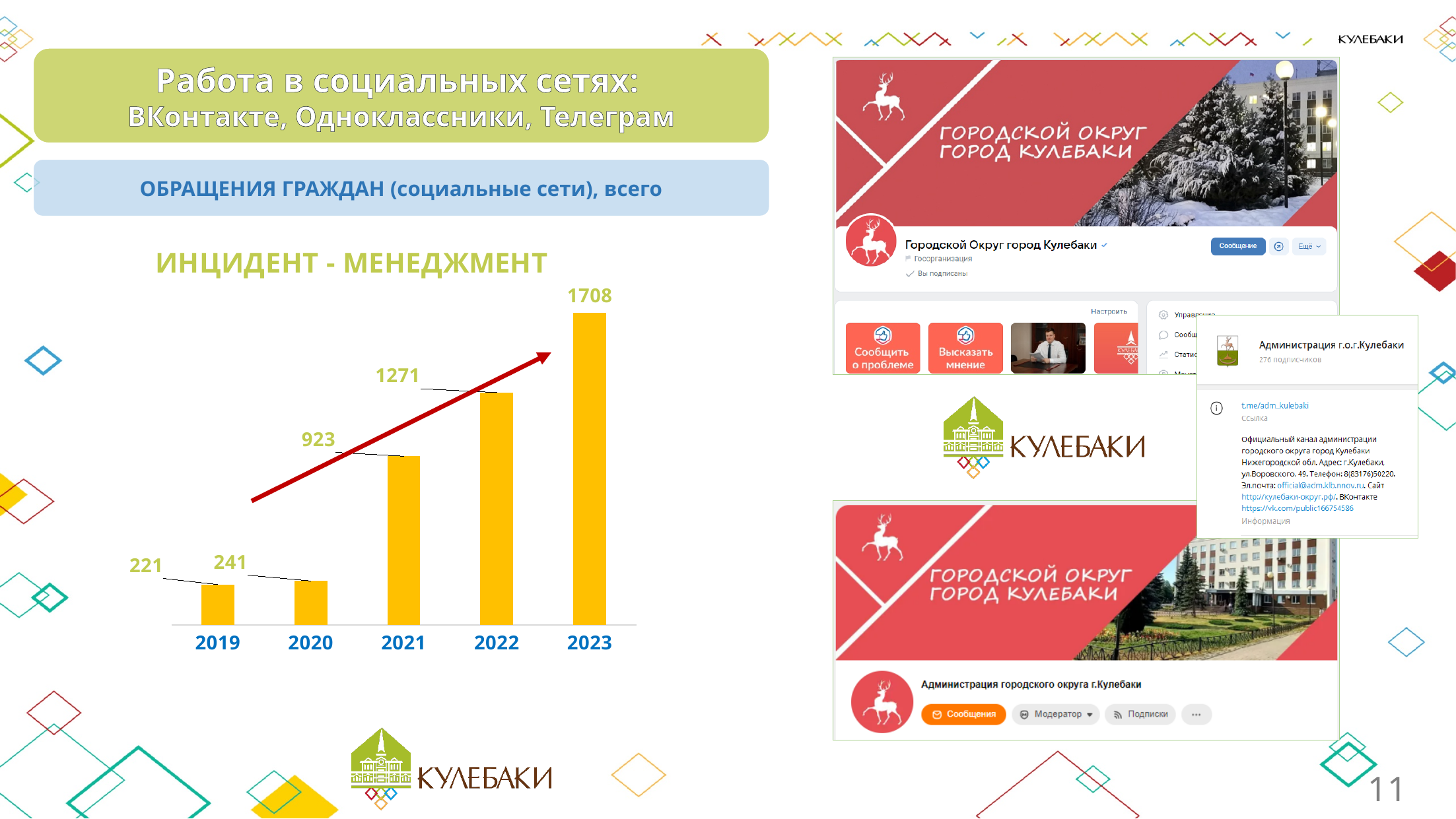
Do the values rise or fall from 2019 to 2023? rise What is the value for 2023? 1708 What is the value for 2021? 923 What is the title of the chart? ИНЦИДЕНТ - МЕНЕДЖМЕНТ Which year has the lowest value? 2019 How many years are shown on the x axis? 5 What is the difference between the values for 2023 and 2022? 437 Which year has the highest value? 2023 What type of chart is shown on the slide? bar chart What is the difference between the values for 2020 and 2019? 20 What is the value for 2019? 221 Which is larger, the value for 2021 or the value for 2022? 2022